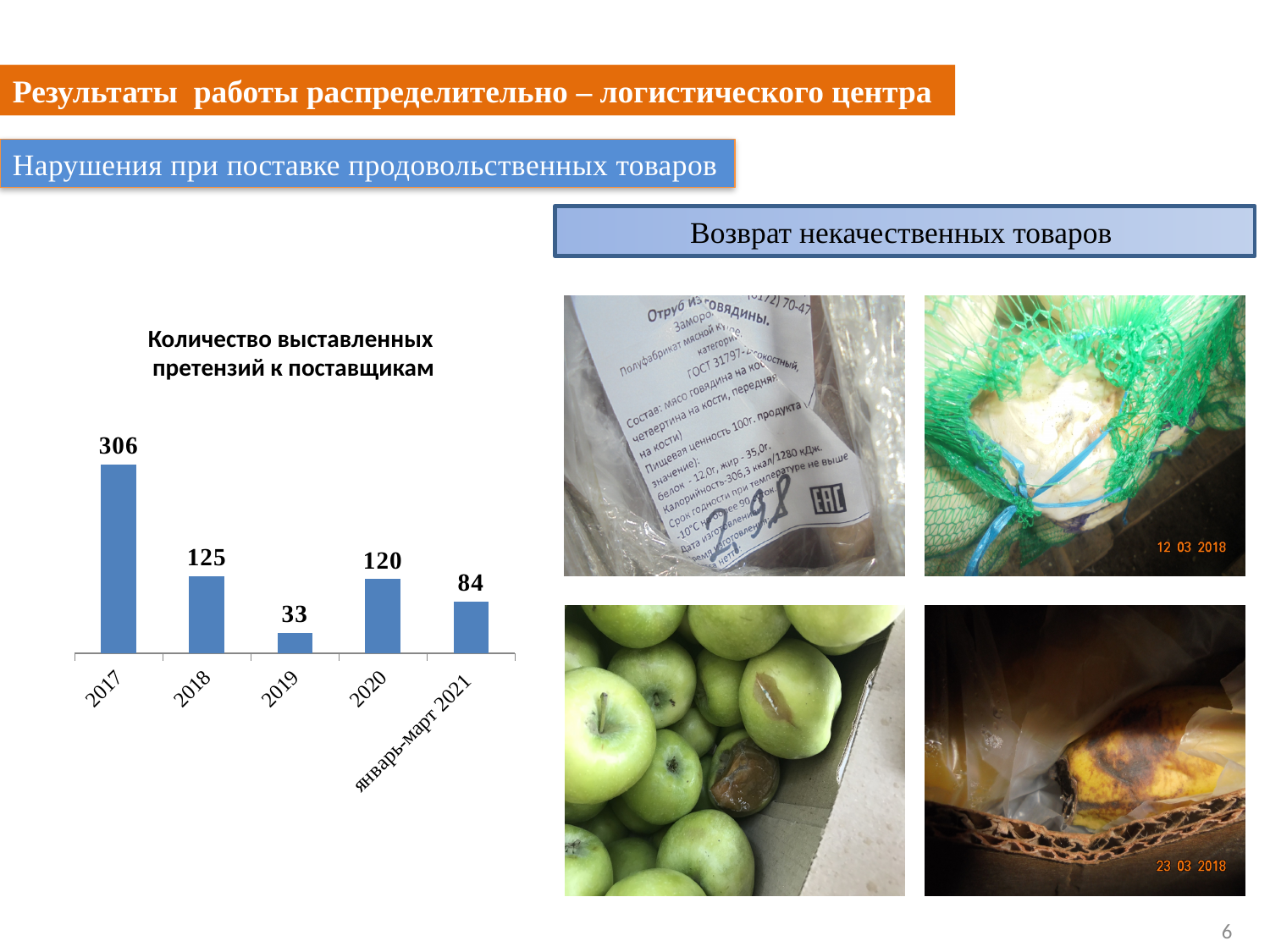
What is the value for январь-март 2021 in the chart? 84 What is the difference between the values for 2020 and январь-март 2021? 36 What is the title of the chart? Количество выставленных претензий к поставщикам Which category has the highest value in the chart? 2017 What is the value for 2019 in the chart? 33 Which is larger, the value for 2018 or the value for 2020? 2018 What is the difference between the values for 2017 and 2018? 181 Do the values rise or fall from 2017 to 2019? fall Which category has the lowest value in the chart? 2019 How many categories are shown on the x axis of the chart? 5 What is the value for 2017 in the chart? 306 What kind of chart is shown on the slide? bar chart